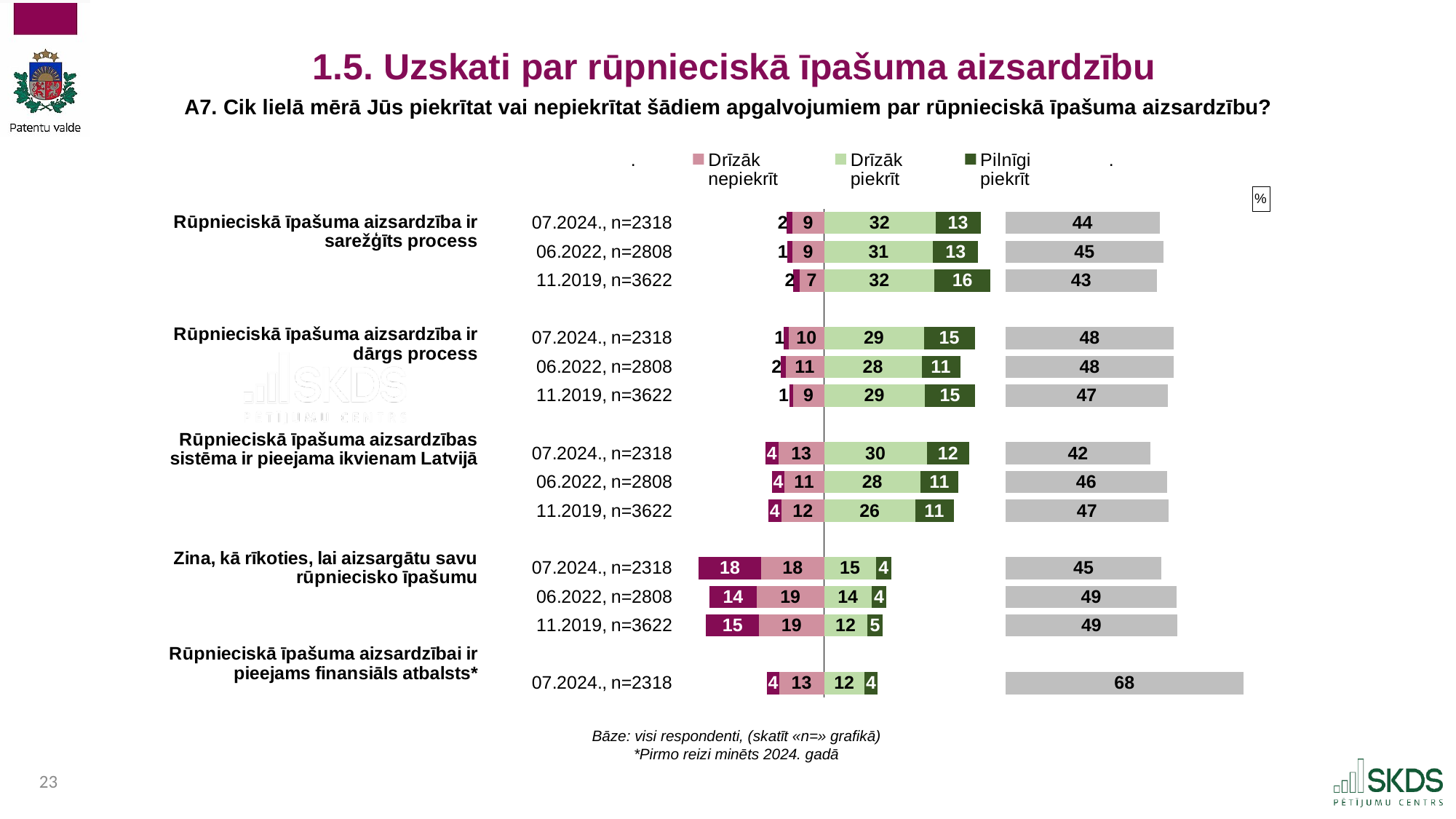
Among the 07.2024 rows, which statement has the highest "Drīzāk piekrīt" value? Rūpnieciskā īpašuma aizsardzība ir sarežģīts process Among the 07.2024 rows, which statement has the lowest "Drīzāk piekrīt" value? Rūpnieciskā īpašuma aizsardzībai ir pieejams finansiāls atbalsts* How many series are listed in the chart legend? 3 What is the "Pilnīgi piekrīt" value for "Rūpnieciskā īpašuma aizsardzība ir dārgs process" in 11.2019? 15 Did the "Pilnīgi piekrīt" value for "Rūpnieciskā īpašuma aizsardzība ir sarežģīts process" rise or fall from 11.2019 to 07.2024? Fall What is the "Drīzāk nepiekrīt" value for "Zina, kā rīkoties, lai aizsargātu savu rūpniecisko īpašumu" in 06.2022? 19 What kind of chart is shown on the slide? Stacked bar chart For "Rūpnieciskā īpašuma aizsardzības sistēma ir pieejama ikvienam Latvijā", is the "Drīzāk nepiekrīt" value larger in 07.2024 or in 06.2022? 07.2024 What is the "Drīzāk piekrīt" value for "Rūpnieciskā īpašuma aizsardzība ir sarežģīts process" in 07.2024? 32 What is the "Drīzāk piekrīt" value for "Rūpnieciskā īpašuma aizsardzībai ir pieejams finansiāls atbalsts*" in 07.2024? 12 For "Rūpnieciskā īpašuma aizsardzība ir sarežģīts process", what is the difference between the "Pilnīgi piekrīt" value in 11.2019 and in 07.2024? 3 How many statements are shown in the chart? 5